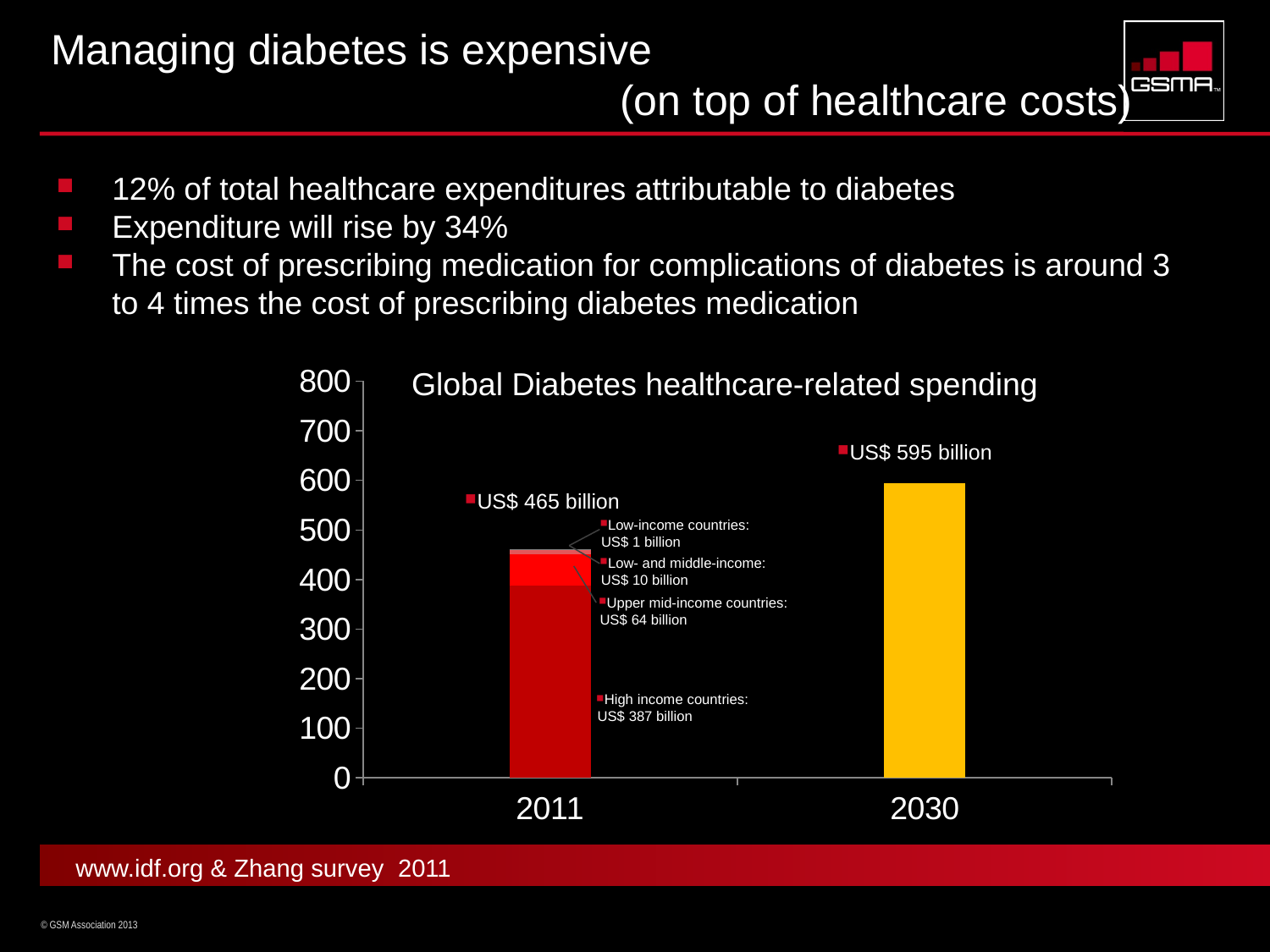
How much of the 2011 spending is attributed to low-income countries? US$ 1 billion How many years are shown on the x axis of the chart? 2 What is the title of the chart? Global Diabetes healthcare-related spending Does spending rise or fall from 2011 to 2030? Rise How much of the 2011 spending is attributed to upper mid-income countries? US$ 64 billion By how much does the 2030 spending exceed the 2011 spending? US$ 130 billion What is the total global diabetes healthcare-related spending shown for 2011? US$ 465 billion How much of the 2011 spending is attributed to high income countries? US$ 387 billion What kind of chart is used to show global diabetes healthcare-related spending? Bar chart What is the global diabetes healthcare-related spending shown for 2030? US$ 595 billion Which year shows the higher spending, 2011 or 2030? 2030 How much of the 2011 spending is attributed to low- and middle-income countries? US$ 10 billion